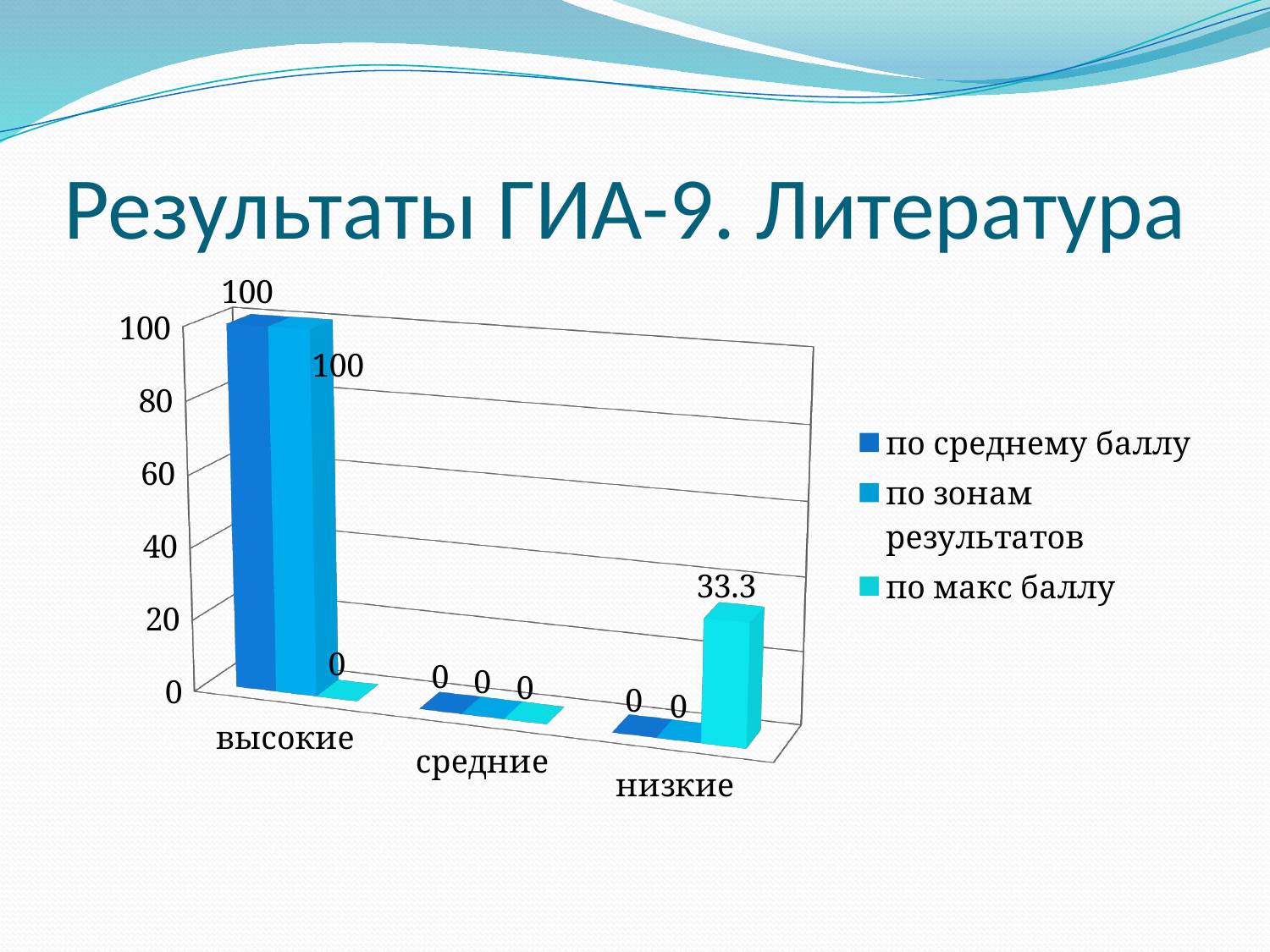
What type of chart is shown on the slide? bar chart How many series does the legend list? 3 What is the difference between the 'по макс баллу' values for 'низкие' and 'высокие'? 33.3 What is the value for 'высокие' in the 'по зонам результатов' series? 100 Which is larger: the 'по зонам результатов' value for 'высокие' or for 'низкие'? высокие What is the value for 'высокие' in the 'по макс баллу' series? 0 What is the value for 'низкие' in the 'по макс баллу' series? 33.3 What is the value for 'высокие' in the 'по среднему баллу' series? 100 What is the title of the slide? Результаты ГИА-9. Литература What is the value for 'средние' in the 'по среднему баллу' series? 0 How many categories are shown on the x axis? 3 Which category has the highest value in the 'по макс баллу' series? низкие